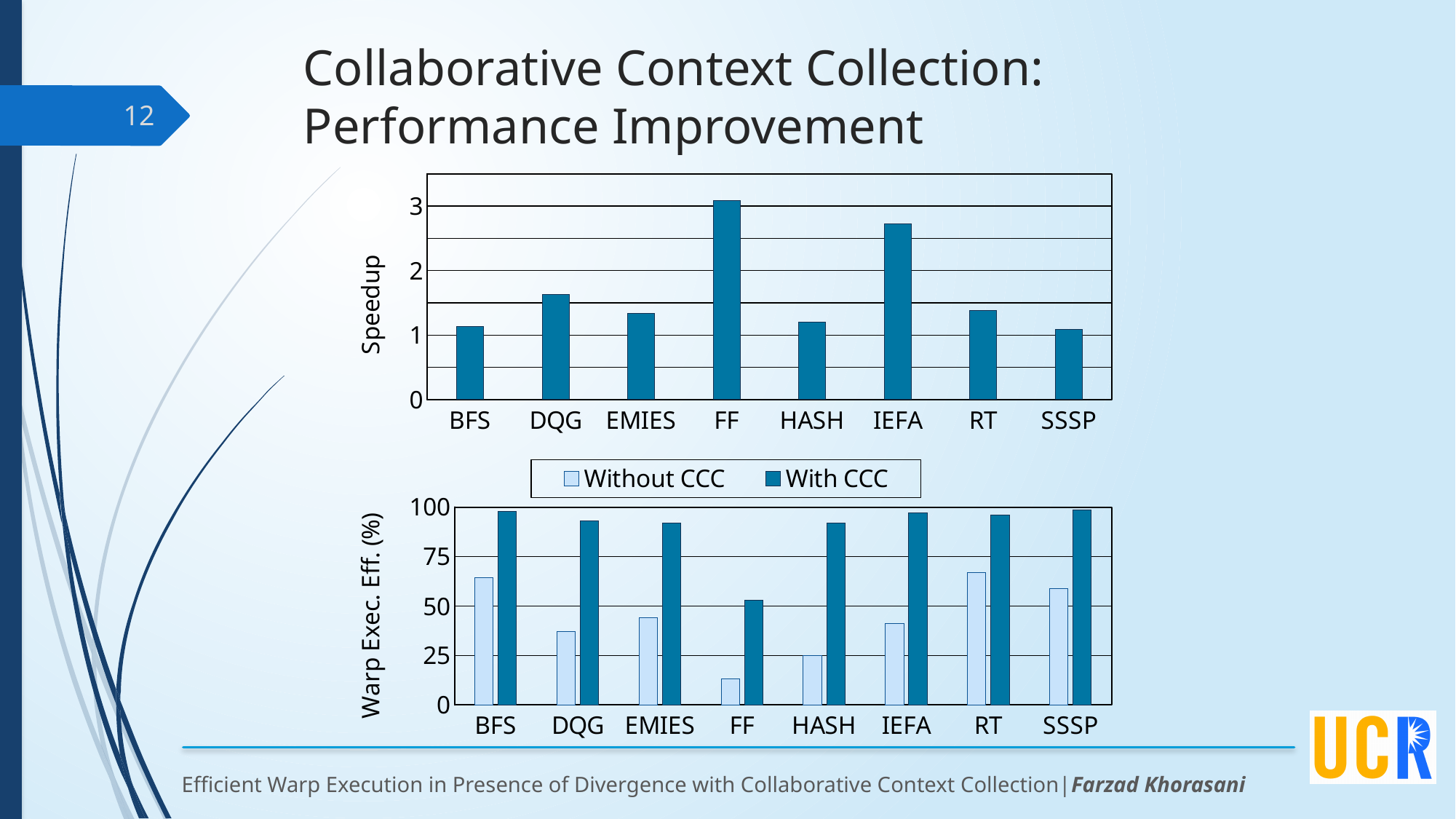
In the top Speedup chart, is the speedup for DQG greater or less than 2? less What type of chart is the top chart (Speedup)? bar chart In the top Speedup chart, how many benchmarks are shown on the x axis? 8 What is the y-axis label of the bottom chart? Warp Exec. Eff. (%) In the top Speedup chart, which benchmark has the highest speedup? FF In the top Speedup chart, is the speedup for IEFA greater or less than 2? greater In the top Speedup chart, which has a larger speedup, DQG or EMIES? DQG In the bottom Warp Exec. Eff. (%) chart, which benchmark has the lowest Without CCC value? FF How many series does the legend of the bottom Warp Exec. Eff. (%) chart list? 2 In the top Speedup chart, which has a larger speedup, FF or IEFA? FF In the bottom Warp Exec. Eff. (%) chart, is the Without CCC value for BFS greater or less than 50? greater In the bottom Warp Exec. Eff. (%) chart, which benchmark has the lowest With CCC value? FF